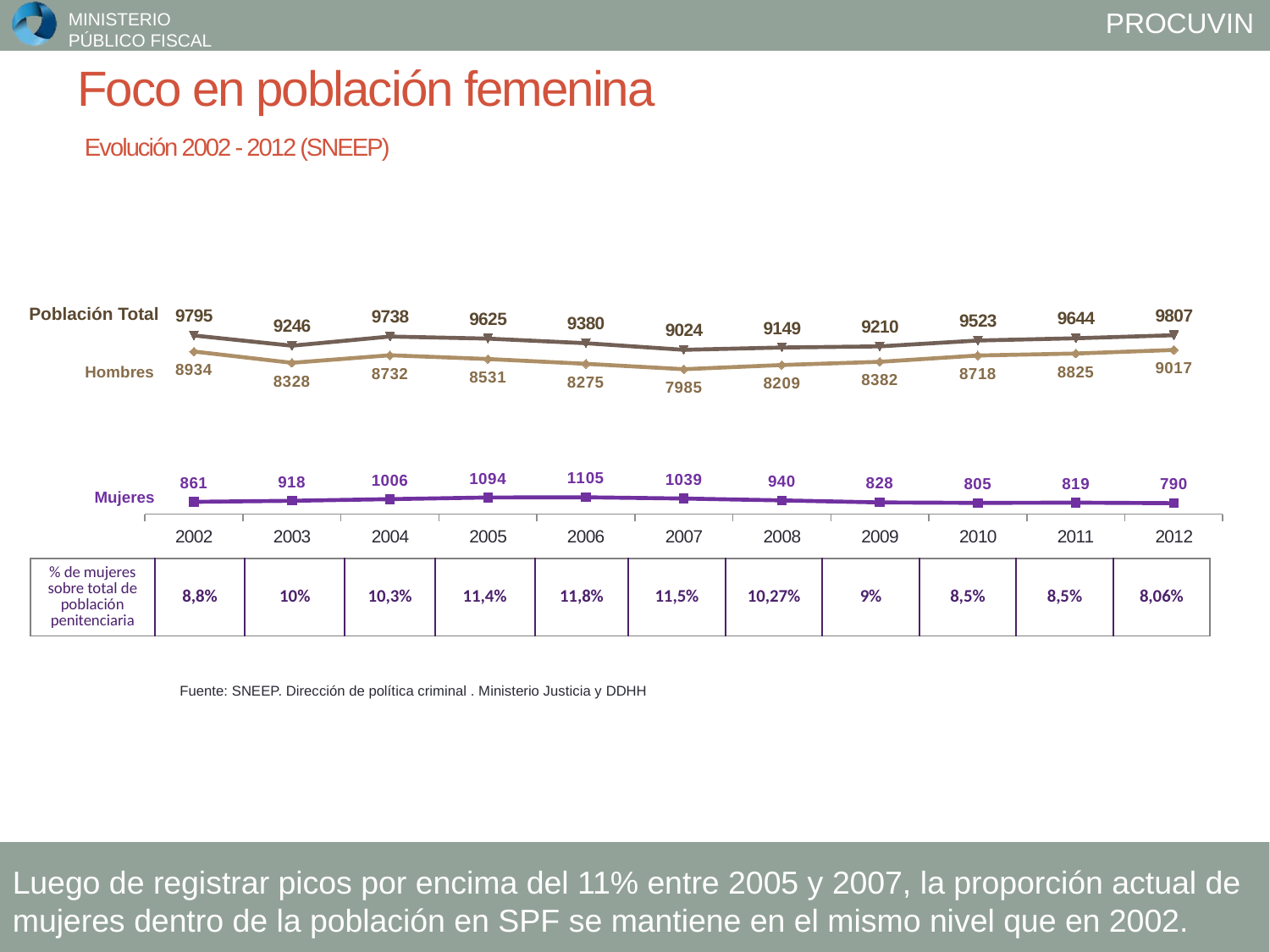
What kind of chart is shown on the slide? line chart What is the Población Total value in 2012? 9807 How many years are shown on the x axis? 11 In which year is the Hombres series at its lowest? 2007 What is the difference between Población Total and Hombres in 2012? 790 By how much did the Mujeres value fall from 2006 to 2012? 315 How many series are plotted in the chart? 3 What is the value for Hombres in 2007? 7985 Which is larger, the Mujeres value in 2003 or in 2008? 2008 Does the Mujeres series rise or fall from 2006 to 2012? fall What is the value for Mujeres in 2006? 1105 In which year is the Mujeres series at its highest? 2006